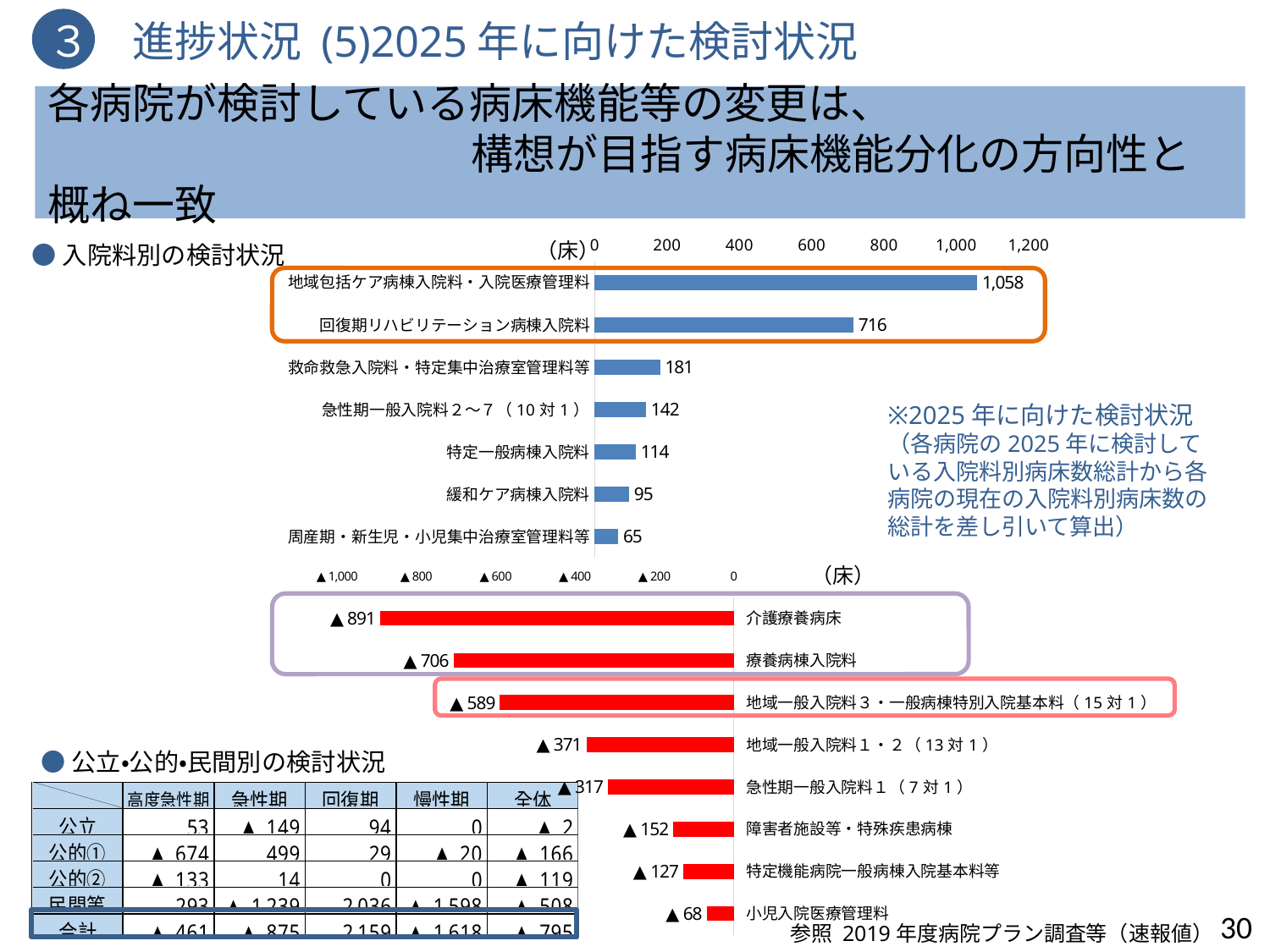
In the upper (blue) bar chart, what is the value for 回復期リハビリテーション病棟入院料? 716 In the lower (red) bar chart, which category has the largest decrease (longest bar)? 介護療養病床 In the upper (blue) bar chart, what is the value for 地域包括ケア病棟入院料・入院医療管理料? 1,058 In the lower (red) bar chart, which category has the smallest decrease (shortest bar)? 小児入院医療管理料 What type of chart is used for the 入院料別の検討状況 data on the slide? Bar chart In the upper (blue) bar chart, how many categories are plotted? 7 In the lower (red) bar chart, what is the value for 介護療養病床? ▲891 In the upper (blue) bar chart, what is the difference between 救命救急入院料・特定集中治療室管理料等 and 急性期一般入院料２～７（10対1）? 39 In the lower (red) bar chart, what is the value for 地域一般入院料３・一般病棟特別入院基本料（15対1）? ▲589 In the lower (red) bar chart, which bar is longer: 療養病棟入院料 or 地域一般入院料１・２（13対1）? 療養病棟入院料 In the upper (blue) bar chart, which category has the lowest value? 周産期・新生児・小児集中治療室管理料等 In the lower (red) bar chart, how many categories are plotted? 8